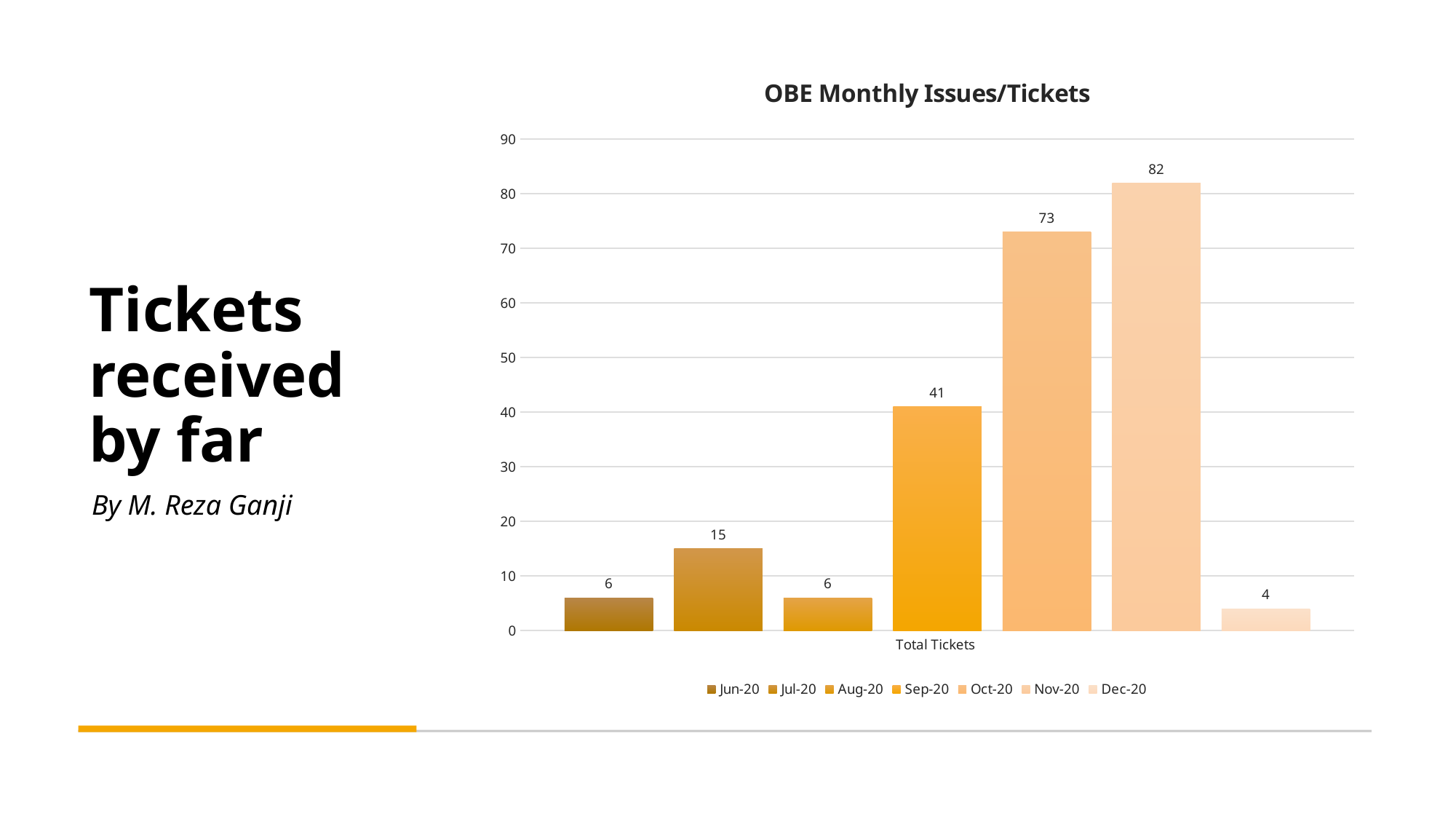
What is the value for Sep-20 in the OBE Monthly Issues/Tickets chart? 41 Which month has the highest number of tickets in the chart? Nov-20 What is the value for Nov-20 in the OBE Monthly Issues/Tickets chart? 82 How many series does the legend list? 7 Which month has the lowest number of tickets in the chart? Dec-20 What kind of chart is shown on the slide? Bar chart What is the difference between the Sep-20 and Jul-20 values? 26 What is the category label shown on the x axis of the chart? Total Tickets Which is larger, the value for Oct-20 or the value for Sep-20? Oct-20 What is the difference between the Nov-20 and Oct-20 values? 9 What is the value for Jul-20 in the OBE Monthly Issues/Tickets chart? 15 What is the title of the chart? OBE Monthly Issues/Tickets